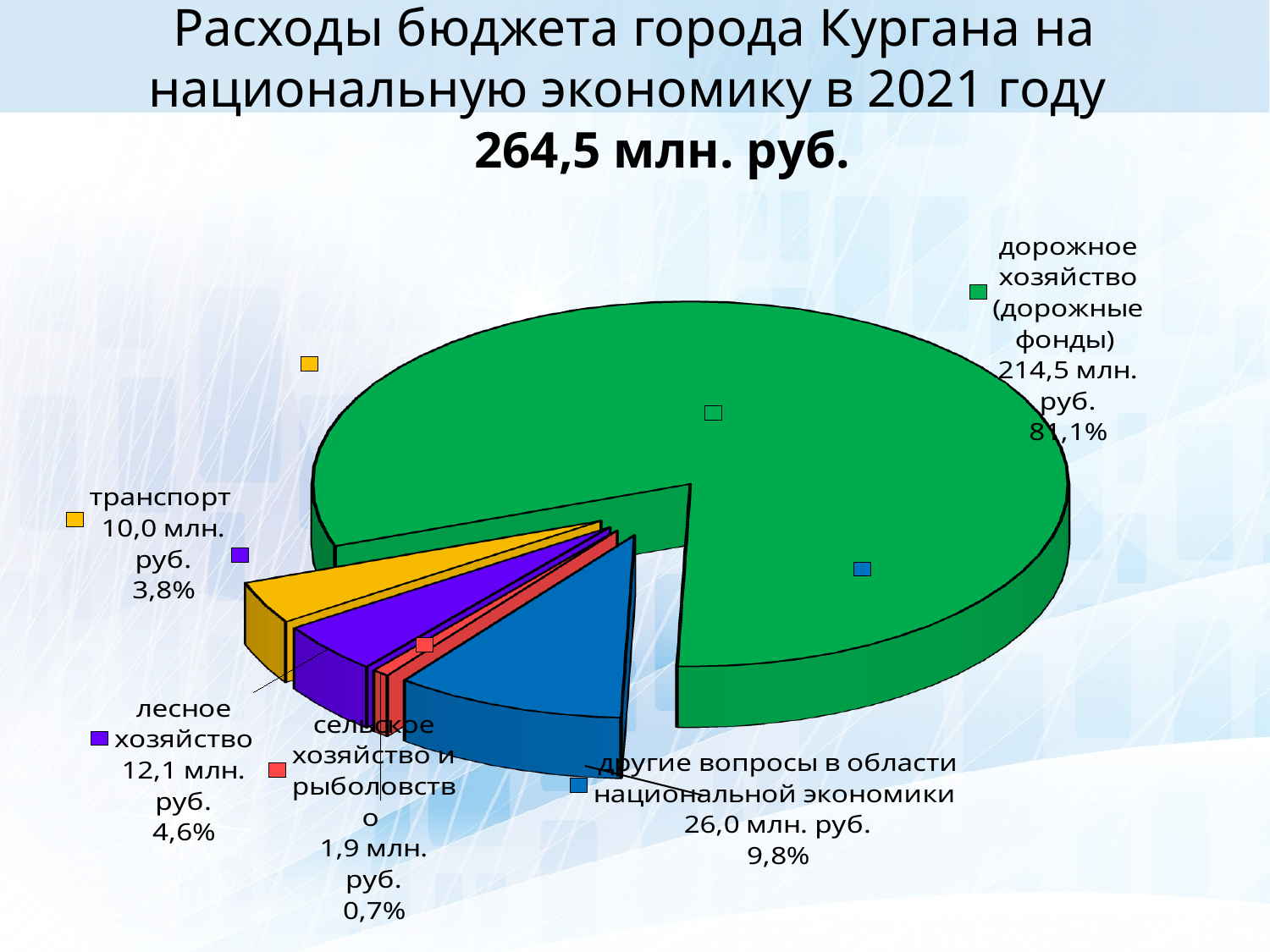
What is the value for транспорт? 10,0 млн. руб. What share of the pie does другие вопросы в области национальной экономики represent? 9,8% What is the value for дорожное хозяйство (дорожные фонды)? 214,5 млн. руб. What is the value for сельское хозяйство и рыболовство? 1,9 млн. руб. Which category has the largest slice? дорожное хозяйство (дорожные фонды) What kind of chart is shown on the slide? pie chart How many slices does the pie chart have? 5 What share of the pie does дорожное хозяйство (дорожные фонды) represent? 81,1% Which category has the smallest slice? сельское хозяйство и рыболовство What share of the pie does лесное хозяйство represent? 4,6% What is the difference between the values for другие вопросы в области национальной экономики and транспорт? 16,0 млн. руб. Which is larger, лесное хозяйство or транспорт? лесное хозяйство